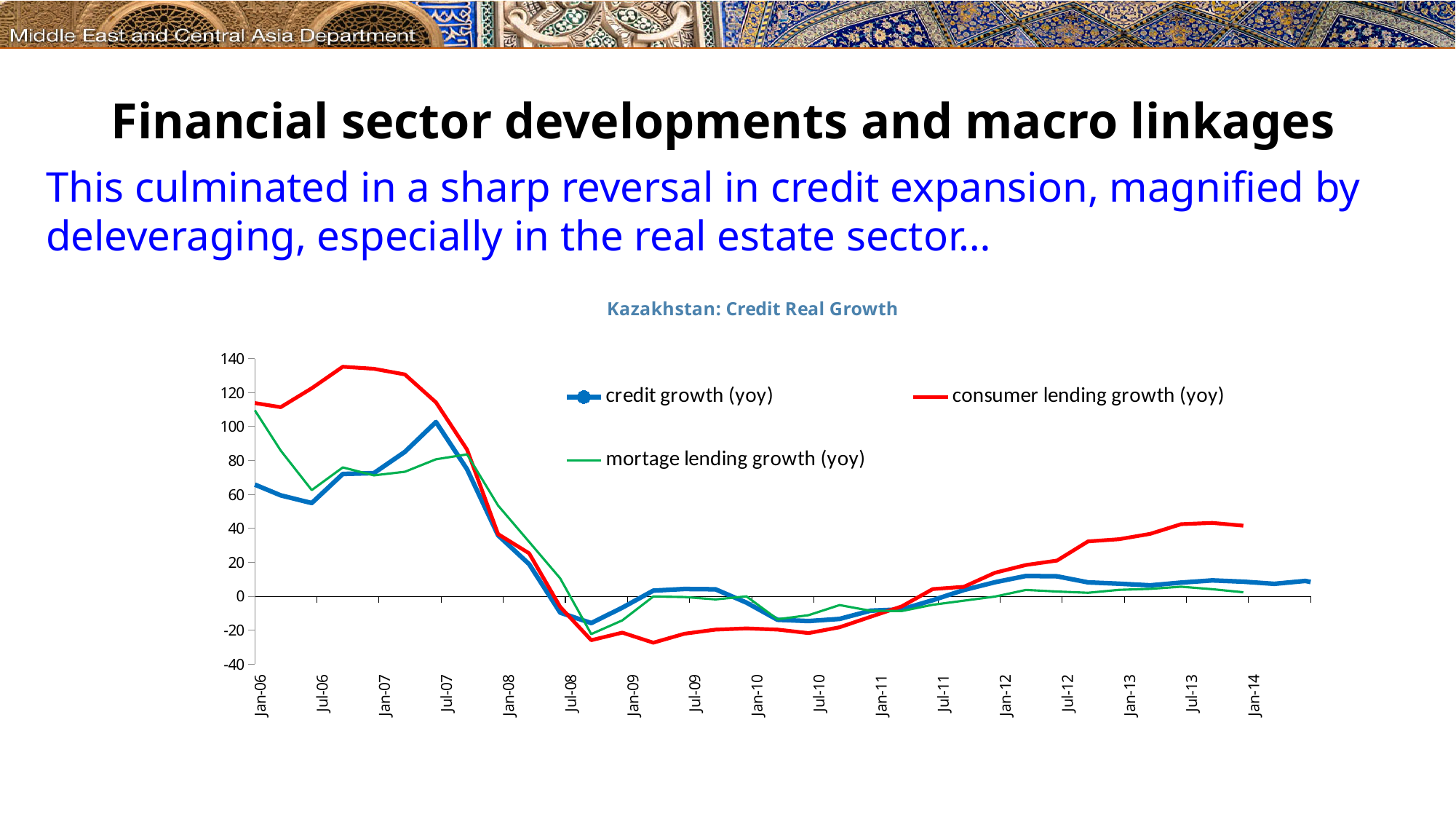
At Jan-14, which series has the higher value: consumer lending growth (yoy) or credit growth (yoy)? consumer lending growth (yoy) What kind of chart is shown on the slide? line chart Is the value for credit growth (yoy) at Jul-07 greater or less than 80? greater Which series reaches the highest peak on the chart? consumer lending growth (yoy) How many series does the legend of the chart list? 3 Is the value for credit growth (yoy) at Jan-10 greater or less than 0? less Is the value for consumer lending growth (yoy) at Jan-14 greater or less than 20? greater Does consumer lending growth (yoy) rise or fall between Jan-11 and Jul-13? rise Does credit growth (yoy) rise or fall between Jul-07 and Jul-08? fall What is the title of the chart? Kazakhstan: Credit Real Growth